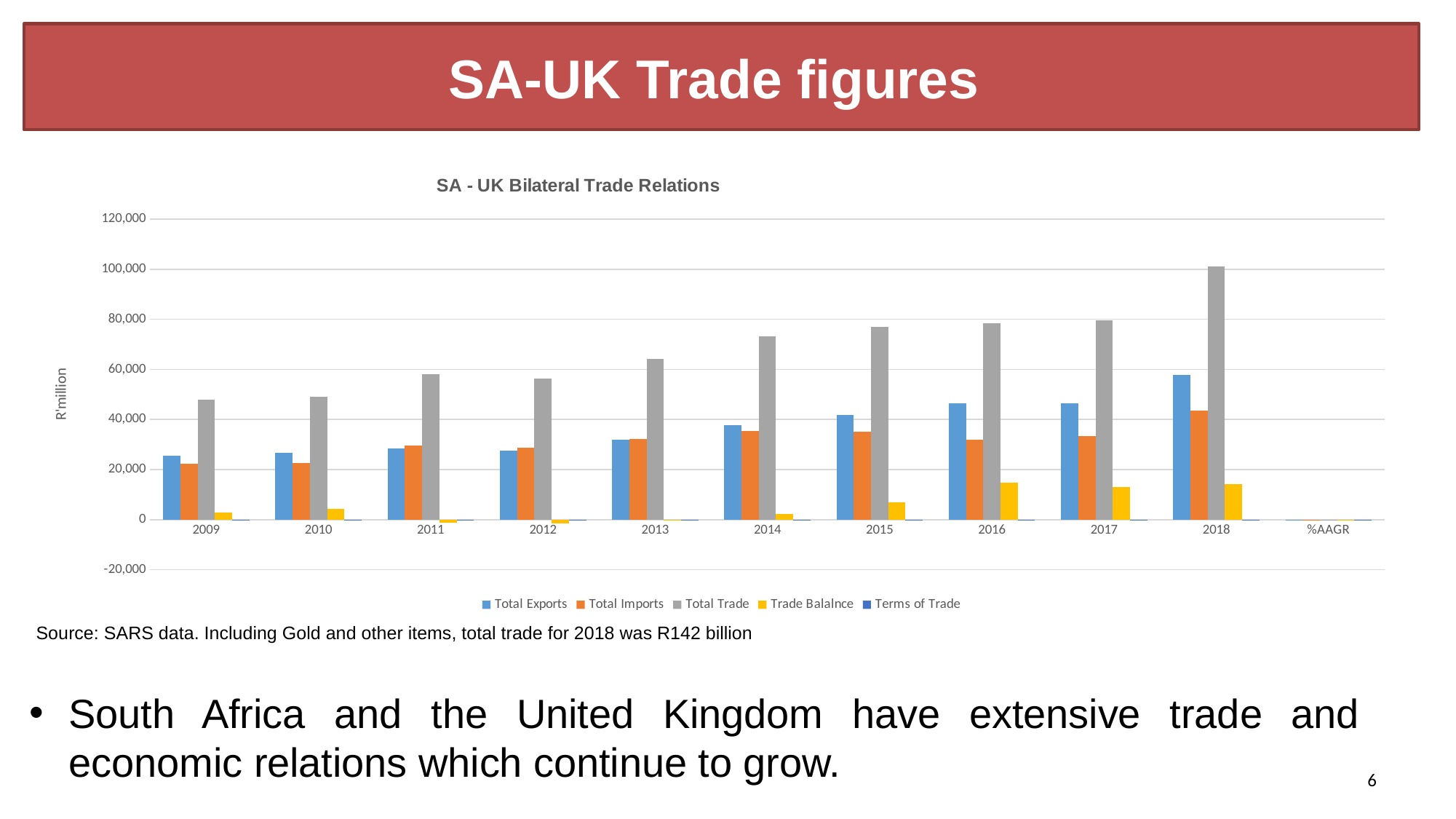
What type of chart is shown on the slide? bar chart What is the title of the chart? SA - UK Bilateral Trade Relations In which year is Total Trade highest? 2018 In 2017, which is larger: Total Exports or Total Imports? Total Exports Is the value of Total Imports for 2009 greater or less than 40,000? less Is the value of Trade Balalnce for 2016 greater or less than 10,000? greater How many series does the chart legend list? 5 Does Total Trade generally rise or fall from 2009 to 2018? rise Is the value of Total Trade for 2014 greater or less than 60,000? greater In which year is Total Exports highest? 2018 How many categories are shown along the x axis of the chart? 11